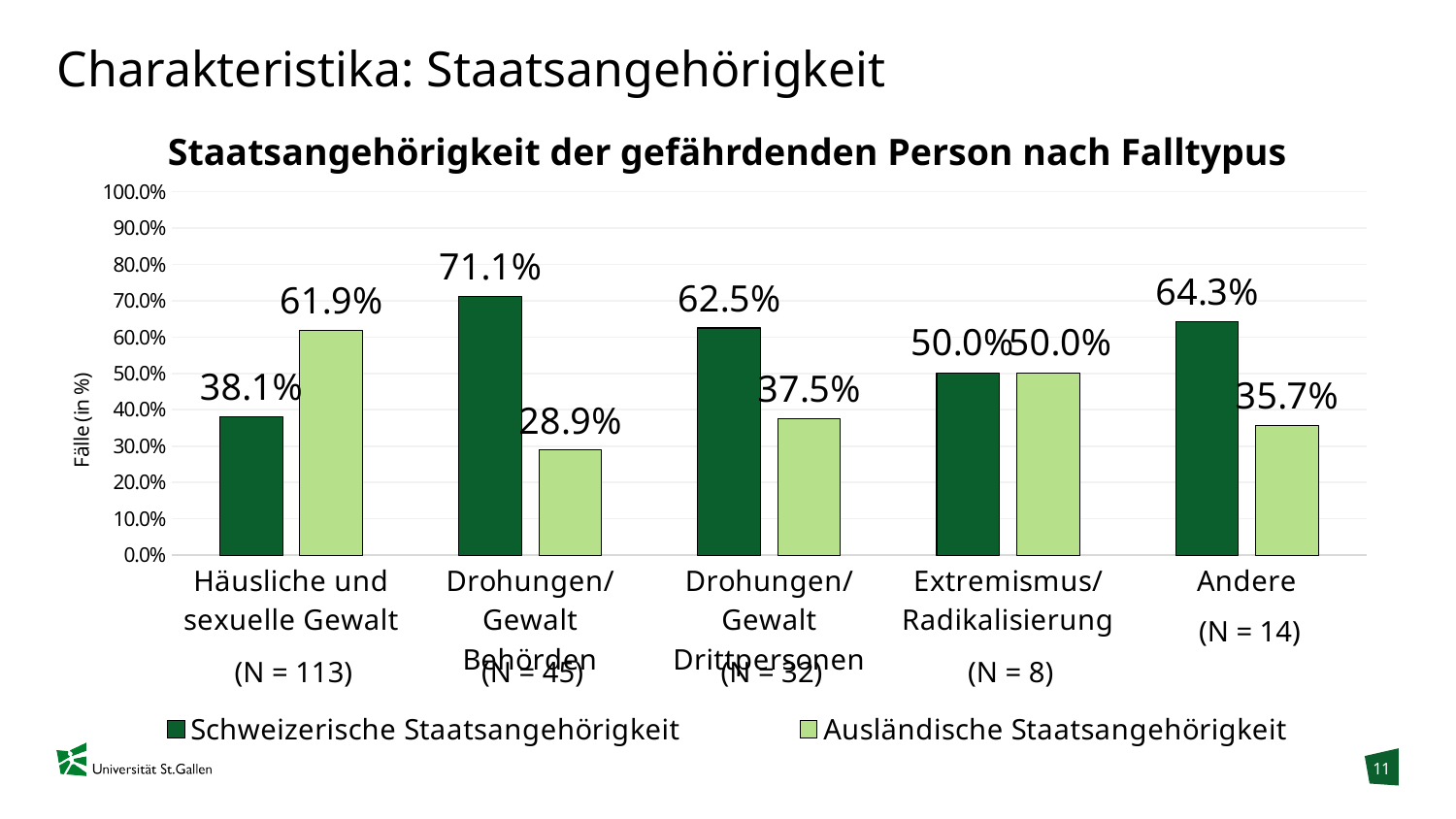
What is the value for Ausländische Staatsangehörigkeit in the category Drohungen/Gewalt Behörden? 28.9% In the category Häusliche und sexuelle Gewalt, which series has the larger value? Ausländische Staatsangehörigkeit Is the value for Ausländische Staatsangehörigkeit in the category Andere greater or less than 40.0%? less What is the difference between the Schweizerische and Ausländische Staatsangehörigkeit values in the category Drohungen/Gewalt Drittpersonen? 25.0% Which category has the lowest value for Ausländische Staatsangehörigkeit? Drohungen/Gewalt Behörden What is the title of the chart? Staatsangehörigkeit der gefährdenden Person nach Falltypus How many series does the legend list? 2 Which category has the highest value for Schweizerische Staatsangehörigkeit? Drohungen/Gewalt Behörden What kind of chart is shown on the slide? bar chart How many categories are shown on the x axis? 5 What is the value for Schweizerische Staatsangehörigkeit in the category Häusliche und sexuelle Gewalt? 38.1% What is the value for Schweizerische Staatsangehörigkeit in the category Andere? 64.3%